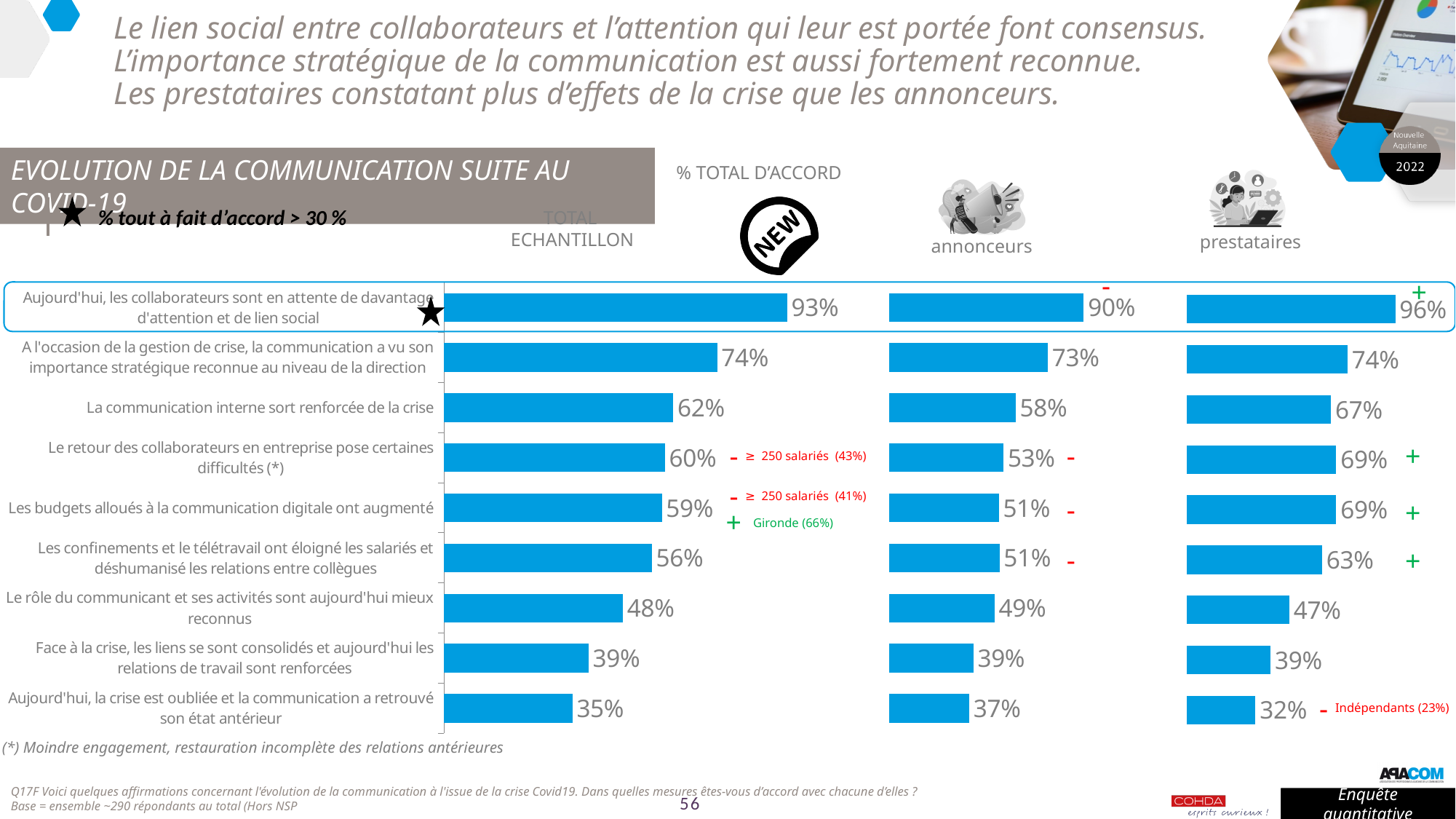
In the TOTAL ECHANTILLON chart, what percentage agrees that 'La communication interne sort renforcée de la crise'? 62% In the prestataires chart, what is the value for 'Le retour des collaborateurs en entreprise pose certaines difficultés (*)'? 69% In the TOTAL ECHANTILLON chart, what is the difference between 'Le retour des collaborateurs en entreprise pose certaines difficultés (*)' (60%) and 'Le rôle du communicant et ses activités sont aujourd'hui mieux reconnus' (48%)? 12 percentage points What type of chart is used to show the % total d'accord values? Bar chart In the TOTAL ECHANTILLON chart, do the values rise or fall going from the top statement to the bottom statement? Fall In the annonceurs chart, what is the value for 'Face à la crise, les liens se sont consolidés et aujourd'hui les relations de travail sont renforcées'? 39% In the prestataires chart, which statement has the highest percentage of agreement? Aujourd'hui, les collaborateurs sont en attente de davantage d'attention et de lien social How many statements (categories) are shown in the TOTAL ECHANTILLON chart? 9 For 'Les confinements et le télétravail ont éloigné les salariés et déshumanisé les relations entre collègues', which group has the larger value, annonceurs or prestataires? prestataires What is the difference between the prestataires value (96%) and the annonceurs value (90%) for 'Aujourd'hui, les collaborateurs sont en attente de davantage d'attention et de lien social'? 6 percentage points In the annonceurs chart, which statement has the lowest percentage of agreement? Aujourd'hui, la crise est oubliée et la communication a retrouvé son état antérieur In the annonceurs chart, what is the value for 'Les budgets alloués à la communication digitale ont augmenté'? 51%